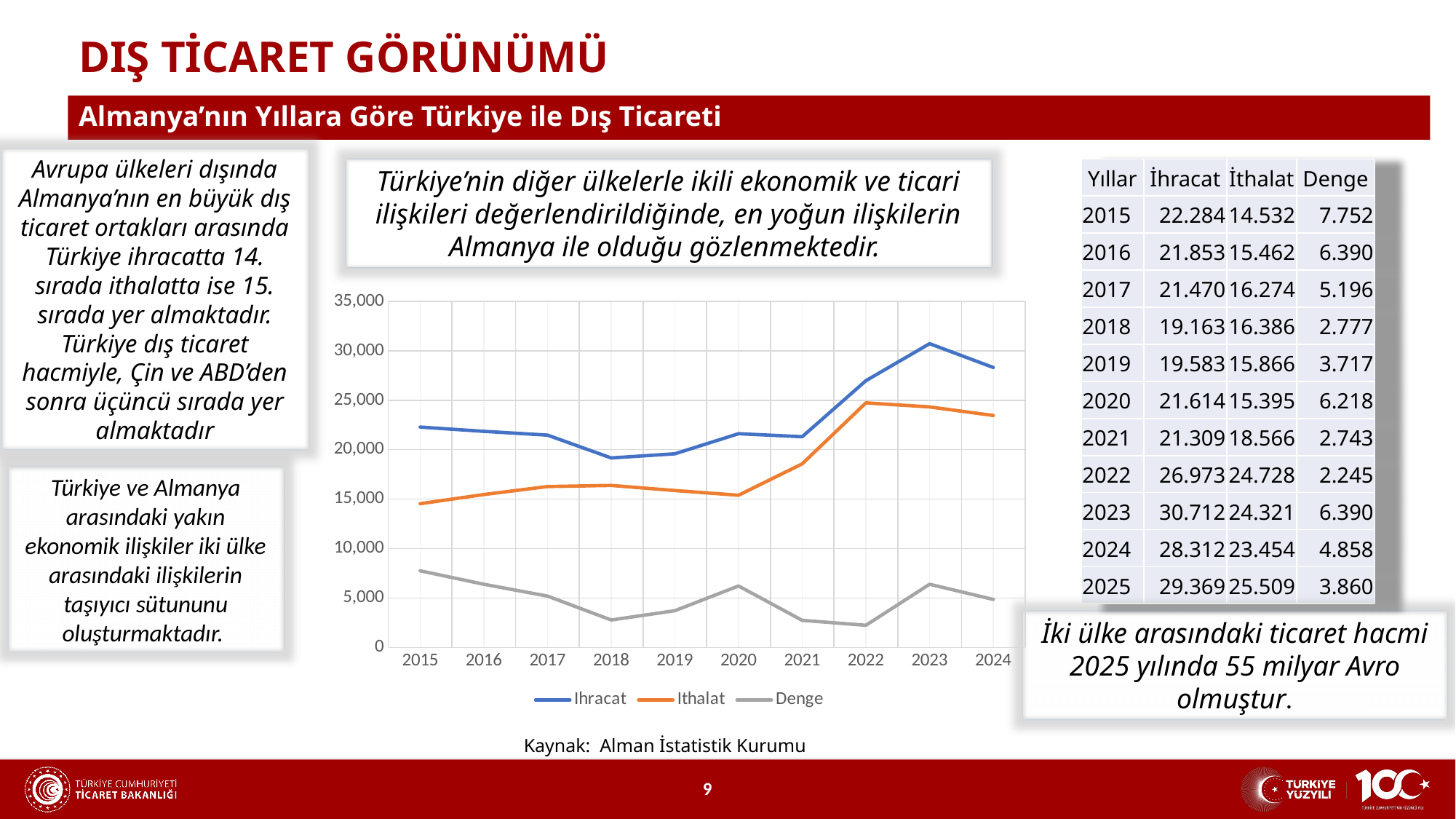
Which series is drawn with the orange line? Ithalat How many series does the chart legend list? 3 In which year does the Ihracat series reach its highest value? 2023 Does the Ihracat series rise or fall from 2021 to 2023? rise Is the Ihracat value for 2018 greater or less than 20,000? less How many years are plotted along the x axis of the chart? 10 Is the Ithalat value for 2015 greater or less than 15,000? less In which year does the Denge series reach its highest value? 2015 Is the Ihracat value for 2023 greater or less than 30,000? greater What kind of chart is shown on the slide? line chart In 2020, which series has the larger value, Ihracat or Ithalat? Ihracat